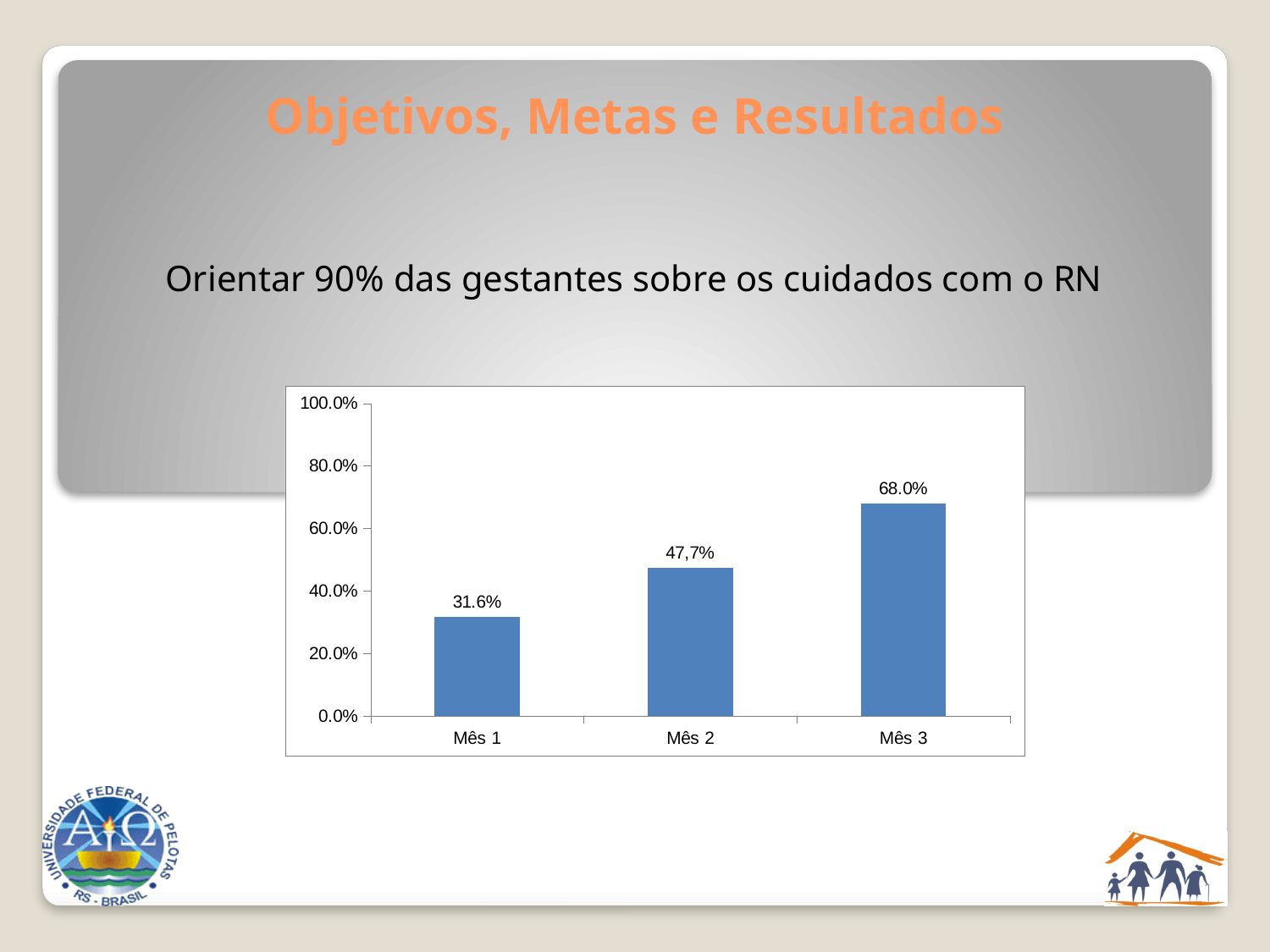
Do the values rise or fall from Mês 1 to Mês 3? rise Which is larger, the value for Mês 2 or the value for Mês 1? Mês 2 Which month has the lowest value? Mês 1 What is the value for Mês 2? 47,7% Is the value for Mês 3 greater or less than 80.0%? less What is the value for Mês 3? 68.0% How many months are shown on the x axis? 3 What is the difference between the values for Mês 3 and Mês 2? 20.3% What is the difference between the values for Mês 3 and Mês 1? 36.4% Which month has the highest value? Mês 3 What kind of chart is shown on the slide? bar chart What is the value for Mês 1? 31.6%